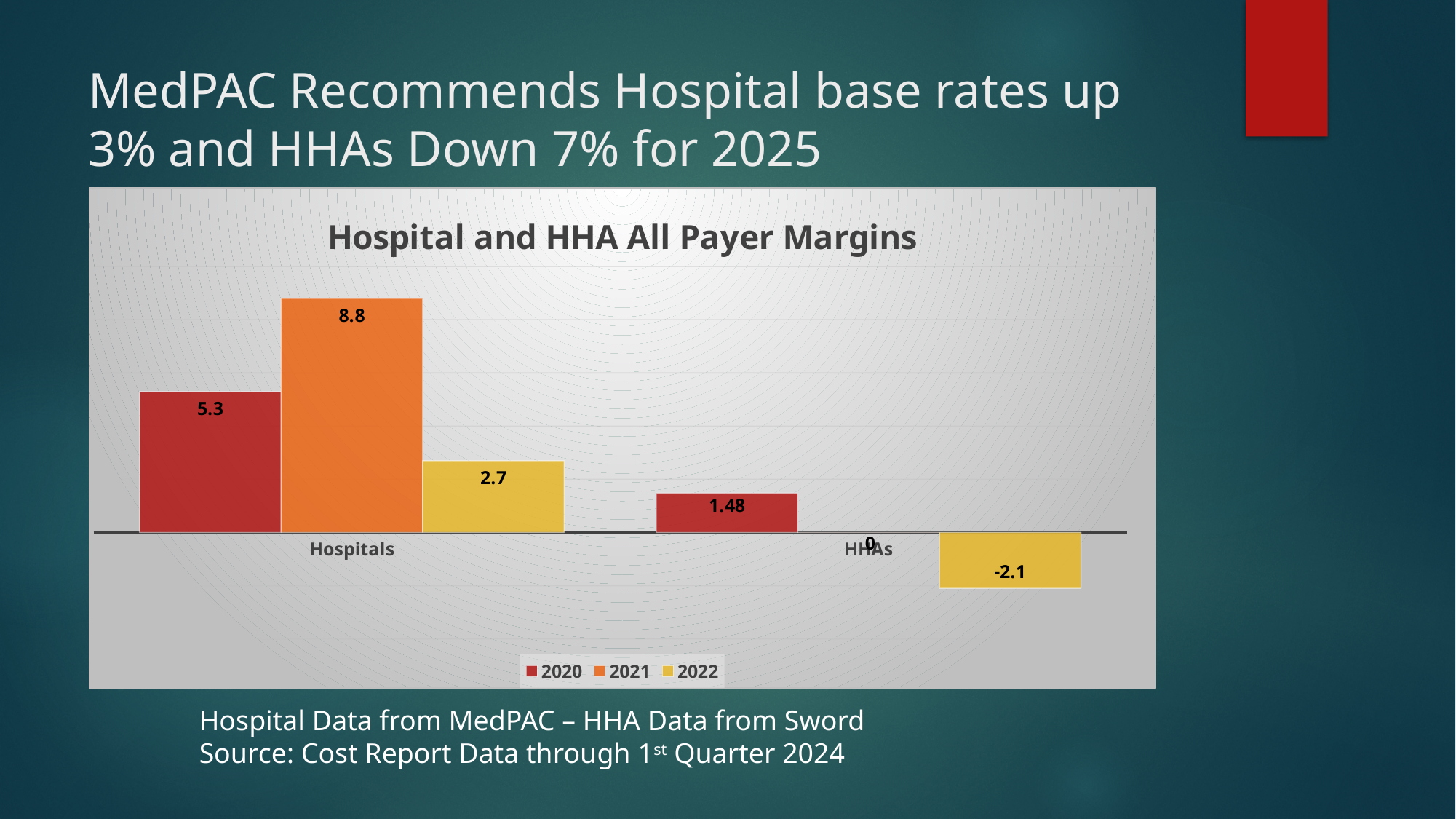
What is the 2022 value for HHAs? -2.1 What is the title of the chart? Hospital and HHA All Payer Margins What is the difference between the 2021 and 2020 values for Hospitals? 3.5 Which year has the highest value for Hospitals? 2021 What type of chart is shown on the slide? bar chart What is the 2021 value for Hospitals? 8.8 What is the 2020 value for HHAs? 1.48 What is the 2022 value for Hospitals? 2.7 How many series does the legend list? 3 Which year has the lowest value for HHAs? 2022 Which is larger, the 2020 value for Hospitals or the 2020 value for HHAs? Hospitals How many categories are shown on the x axis? 2